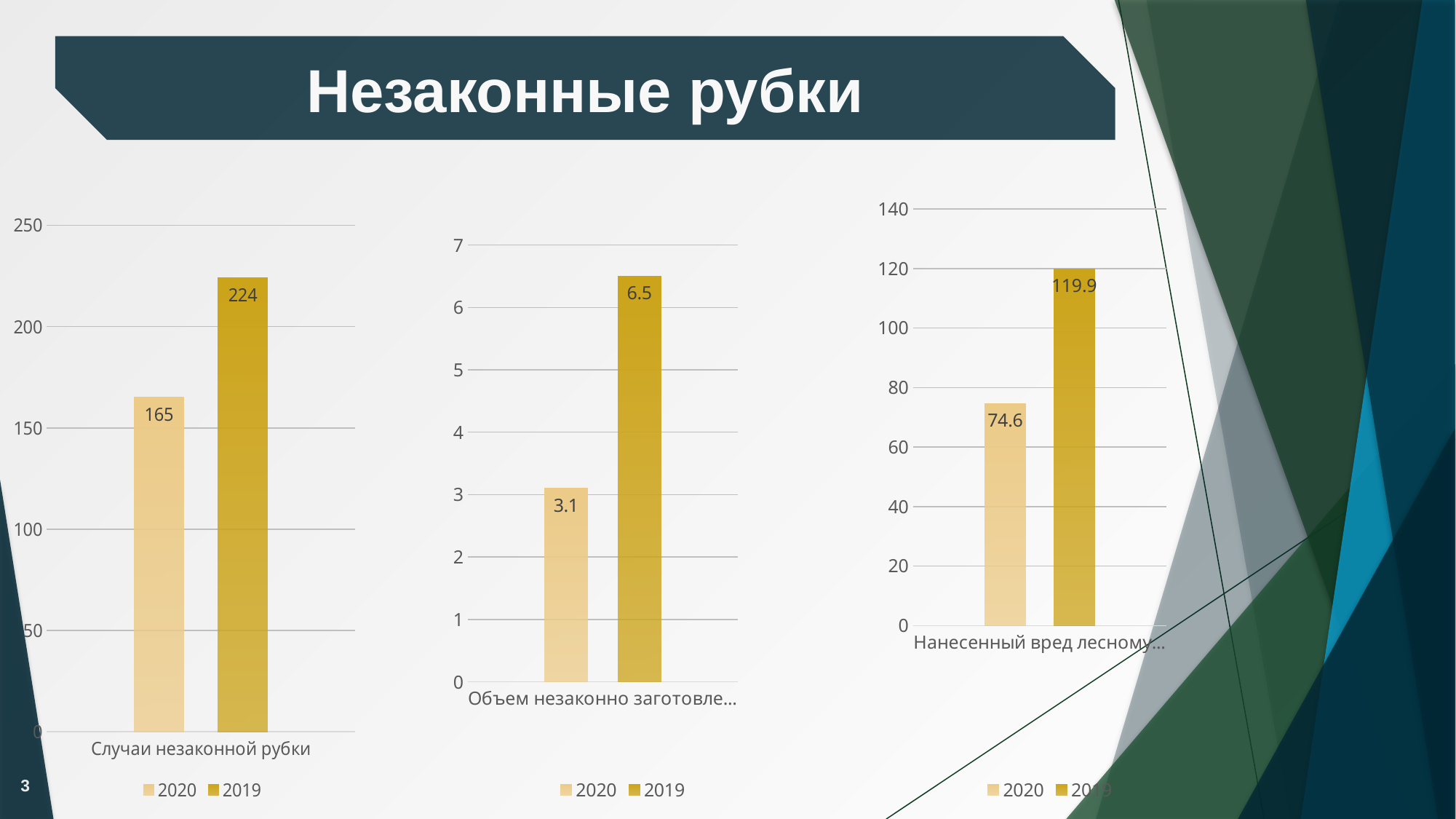
On the left chart (Случаи незаконной рубки), which year has the higher value, 2019 or 2020? 2019 What kind of chart is the middle chart? bar chart On the left chart (Случаи незаконной рубки), what is the difference between the 2019 and 2020 values? 59 On the middle chart, what is the difference between the 2019 and 2020 values? 3.4 How many series does the legend of the left chart list? 2 On the left chart (Случаи незаконной рубки), what is the value for 2020? 165 On the right chart, which year has the lower value, 2019 or 2020? 2020 On the middle chart, what is the value for 2020? 3.1 On the right chart, what is the value for 2020? 74.6 On the middle chart, what is the value for 2019? 6.5 On the left chart (Случаи незаконной рубки), what is the value for 2019? 224 On the right chart, what is the value for 2019? 119.9